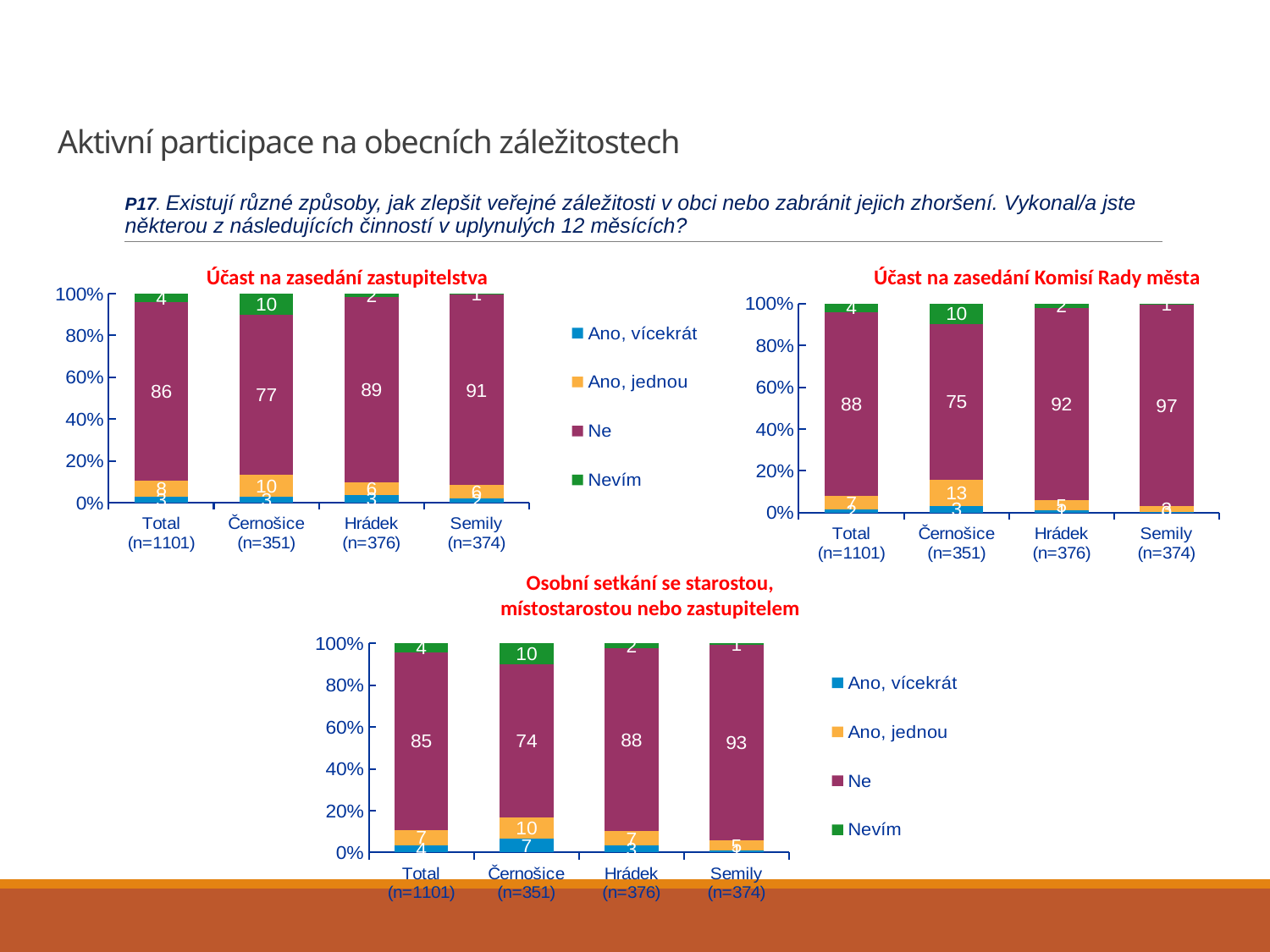
In the chart titled 'Účast na zasedání Komisí Rady města', which category has the lowest 'Ne' value? Černošice In the chart titled 'Účast na zasedání zastupitelstva', which category has the highest 'Ne' value? Semily In the chart titled 'Účast na zasedání Komisí Rady města', what is the value of 'Ne' for Semily? 97 In the chart titled 'Osobní setkání se starostou, místostarostou nebo zastupitelem', what is the value of 'Ne' for Hrádek? 88 In the chart titled 'Osobní setkání se starostou, místostarostou nebo zastupitelem', is the 'Ne' value larger for Total or for Černošice? Total What kind of chart is the chart titled 'Osobní setkání se starostou, místostarostou nebo zastupitelem'? Stacked bar chart How many series does the legend of the chart titled 'Účast na zasedání zastupitelstva' list? 4 In the chart titled 'Účast na zasedání zastupitelstva', what is the value of 'Ne' for Černošice? 77 In the chart titled 'Osobní setkání se starostou, místostarostou nebo zastupitelem', what is the 'Nevím' value for Černošice? 10 In the chart titled 'Účast na zasedání zastupitelstva', what is the difference between the 'Ne' values for Hrádek and Total? 3 In the chart titled 'Účast na zasedání Komisí Rady města', what is the value of 'Ano, jednou' for Černošice? 13 How many categories are shown on the x axis of the chart titled 'Účast na zasedání Komisí Rady města'? 4